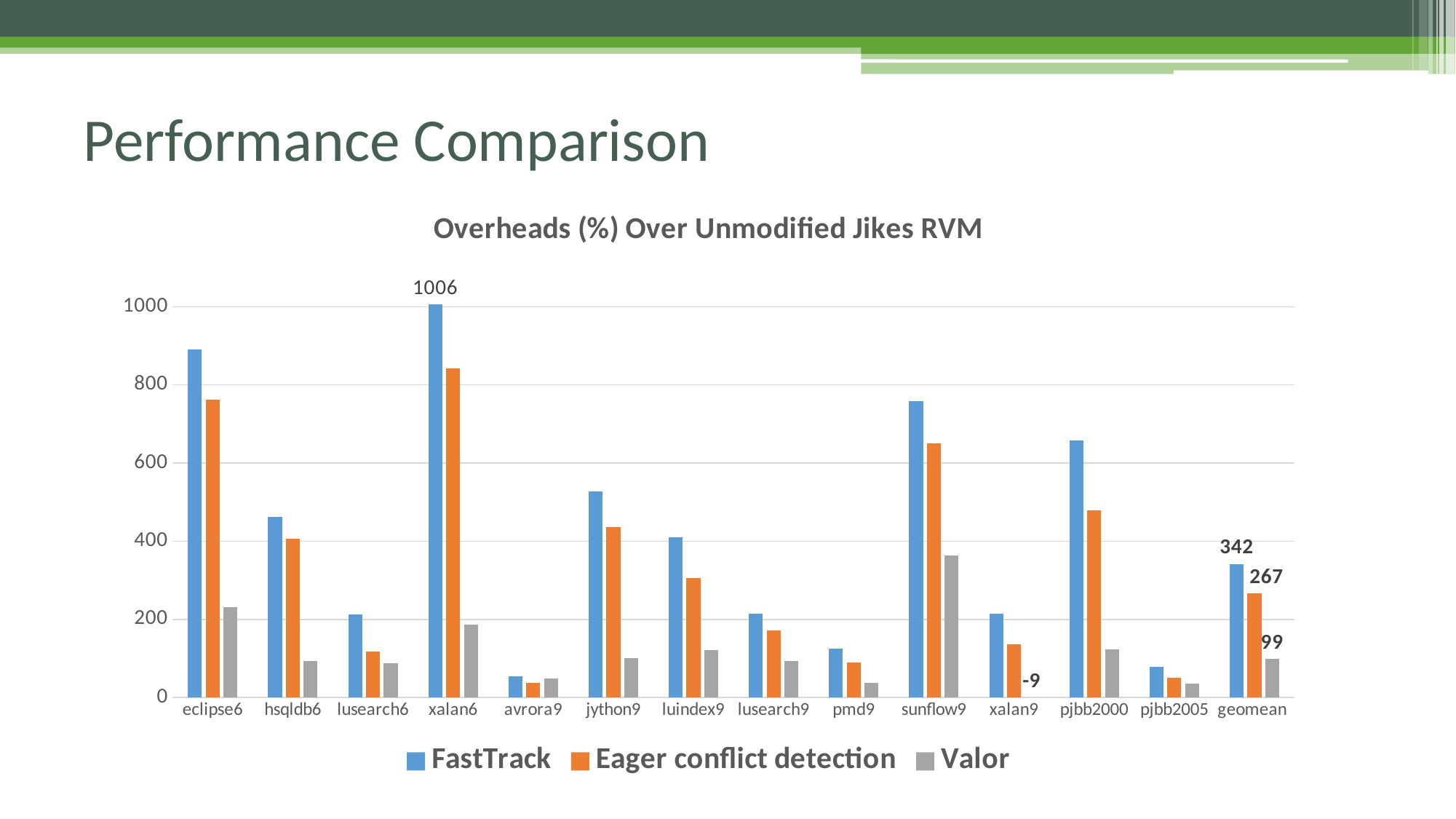
What is the Valor value for xalan9? -9 What is the FastTrack value for geomean? 342 What is the FastTrack overhead for xalan6? 1006 For geomean, what is the difference between the FastTrack value and the Eager conflict detection value? 75 Is the FastTrack value for eclipse6 greater or less than 800? greater Which benchmark has the highest FastTrack overhead? xalan6 How many series does the legend list? 3 Which has the larger FastTrack value, sunflow9 or pjbb2000? sunflow9 What is the Valor value for geomean? 99 How many benchmark categories are shown on the x axis? 14 What is the Eager conflict detection value for geomean? 267 Which benchmark has the lowest Valor value? xalan9